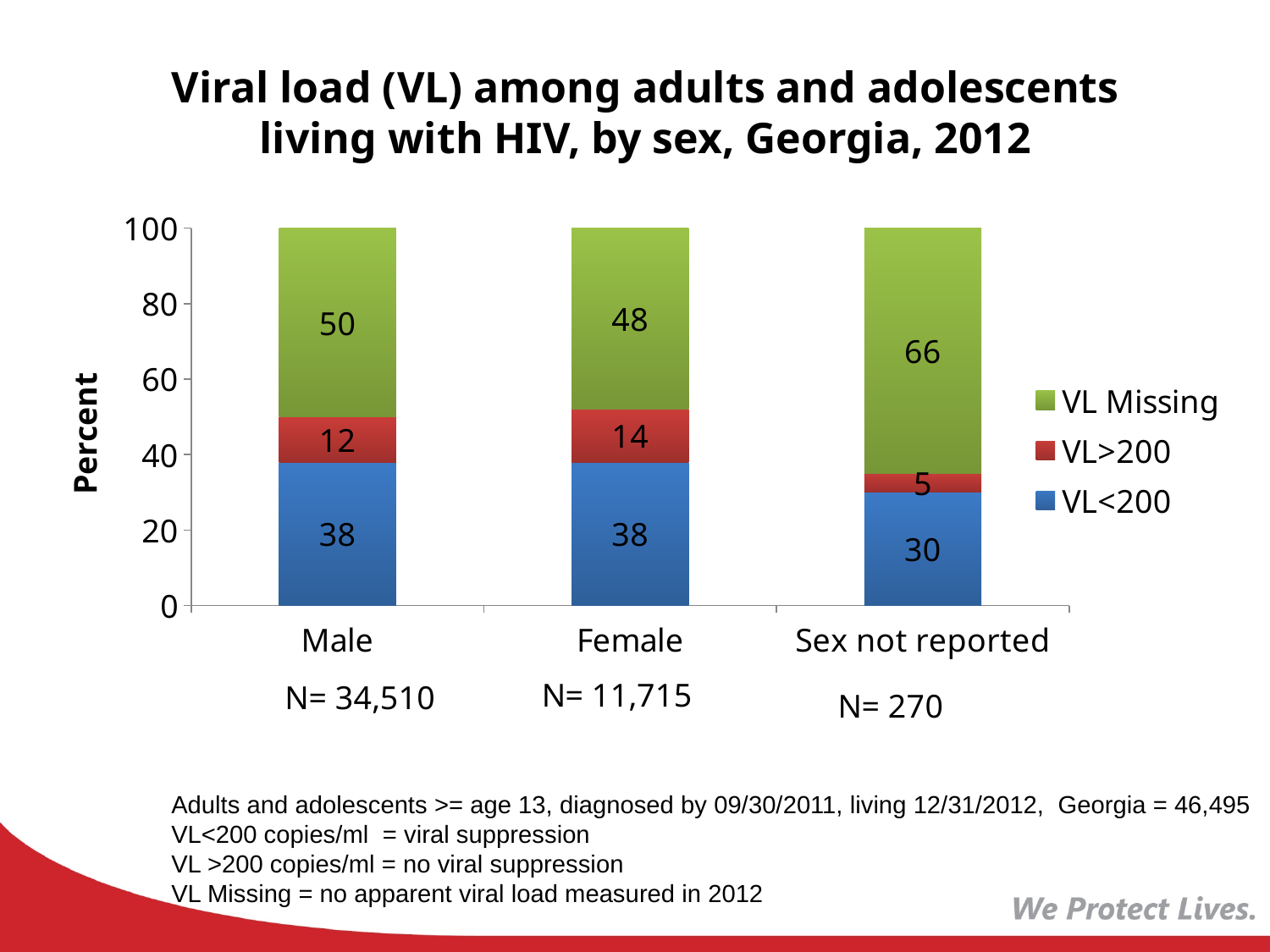
What is the VL Missing value for Male? 50 How many series does the legend list? 3 What is the y-axis label of the chart? Percent How many categories are shown on the x axis? 3 Is the VL>200 value larger for Male or for Female? Female What is the difference between the VL Missing values for Sex not reported and Male? 16 What is the VL>200 value for Female? 14 What is the total of the stacked bar for Female? 100 Which category has the lowest VL>200 value? Sex not reported What is the VL<200 value for Sex not reported? 30 What kind of chart is shown? Stacked bar chart Which category has the highest VL Missing value? Sex not reported